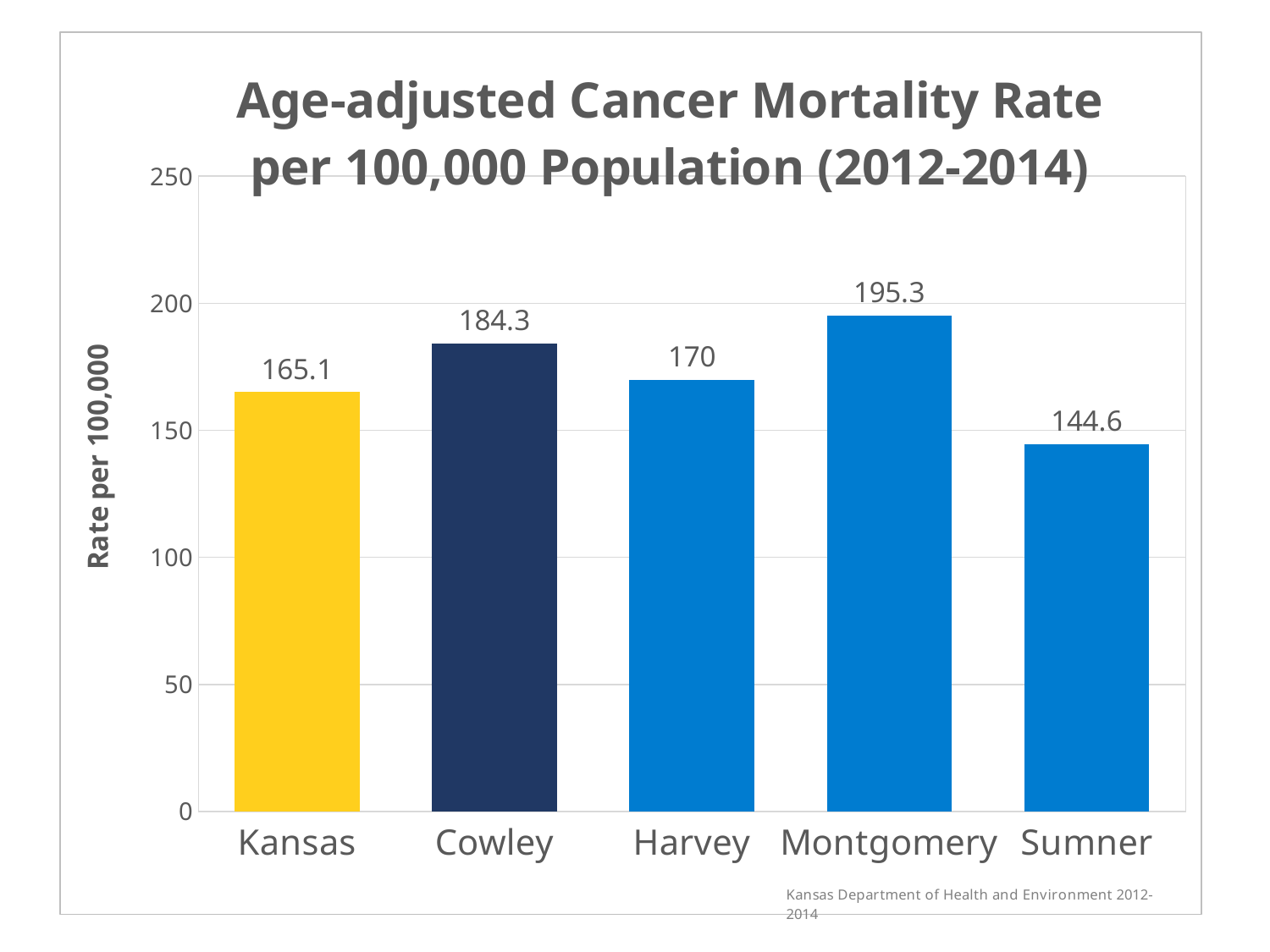
What kind of chart is shown on the slide? Bar chart Which category has the highest age-adjusted cancer mortality rate? Montgomery What is the age-adjusted cancer mortality rate for Kansas? 165.1 Which category has the lowest age-adjusted cancer mortality rate? Sumner How many categories are shown on the x axis? 5 Is the value for Harvey greater or less than 150? greater What is the difference between the rates for Cowley and Kansas? 19.2 What is the difference between the rates for Montgomery and Sumner? 50.7 Which has a higher age-adjusted cancer mortality rate, Harvey or Cowley? Cowley What is the label of the vertical axis? Rate per 100,000 What is the age-adjusted cancer mortality rate for Sumner? 144.6 What is the age-adjusted cancer mortality rate for Cowley? 184.3